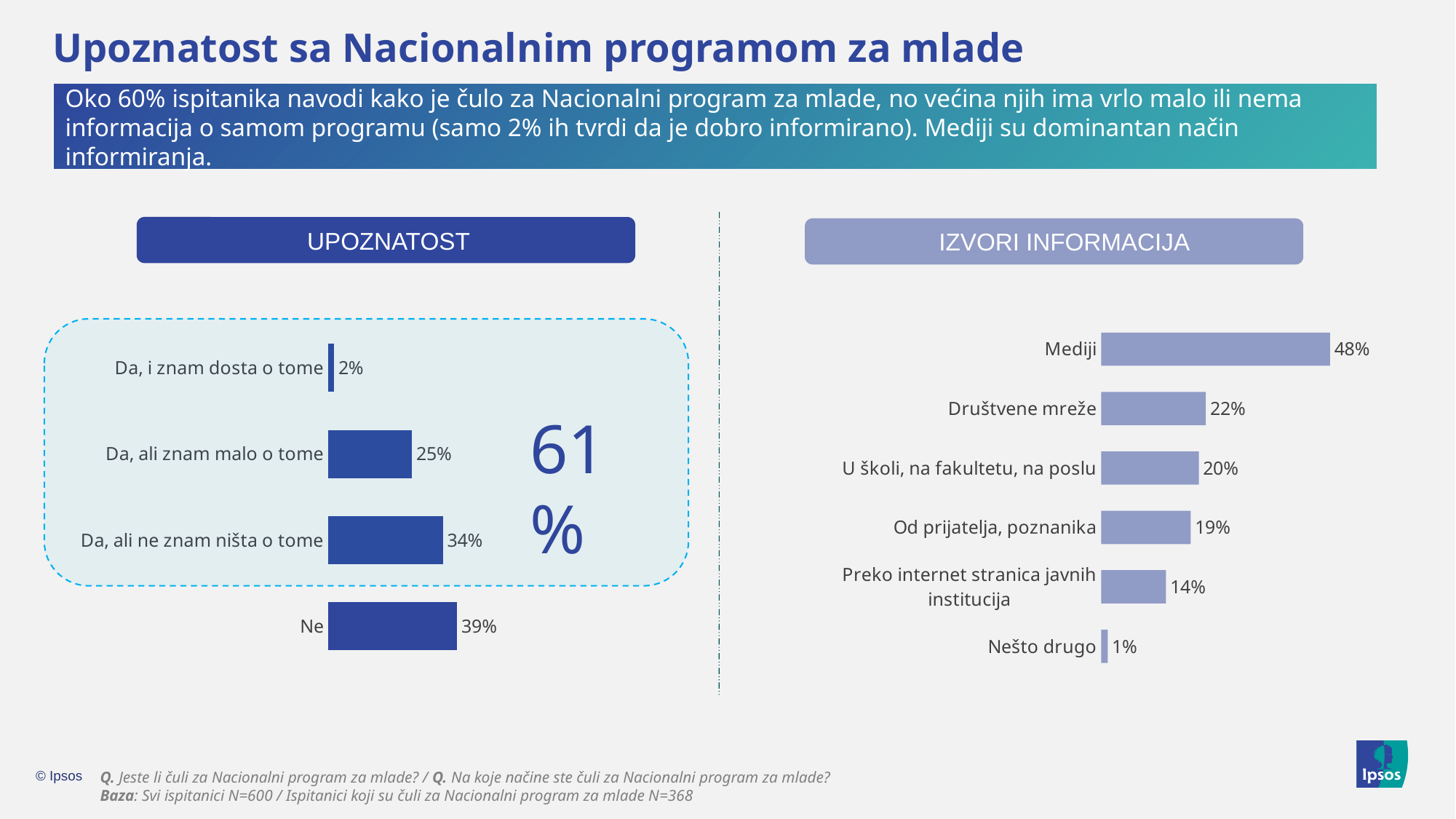
In the UPOZNATOST chart, which category has the highest value? Ne What type of chart is the IZVORI INFORMACIJA chart? Bar chart In the IZVORI INFORMACIJA chart, what is the difference between "Mediji" and "Društvene mreže"? 26% In the UPOZNATOST chart, what is the value for "Da, ali znam malo o tome"? 25% In the UPOZNATOST chart, what is the value for "Ne"? 39% In the IZVORI INFORMACIJA chart, what is the value for "Preko internet stranica javnih institucija"? 14% In the IZVORI INFORMACIJA chart, which category has the highest value? Mediji In the IZVORI INFORMACIJA chart, what is the value for "Mediji"? 48% In the UPOZNATOST chart, what is the difference between "Ne" and "Da, ali ne znam ništa o tome"? 5% In the IZVORI INFORMACIJA chart, which is larger: "Društvene mreže" or "Od prijatelja, poznanika"? Društvene mreže In the UPOZNATOST chart, how many categories are shown? 4 In the UPOZNATOST chart, which category has the lowest value? Da, i znam dosta o tome